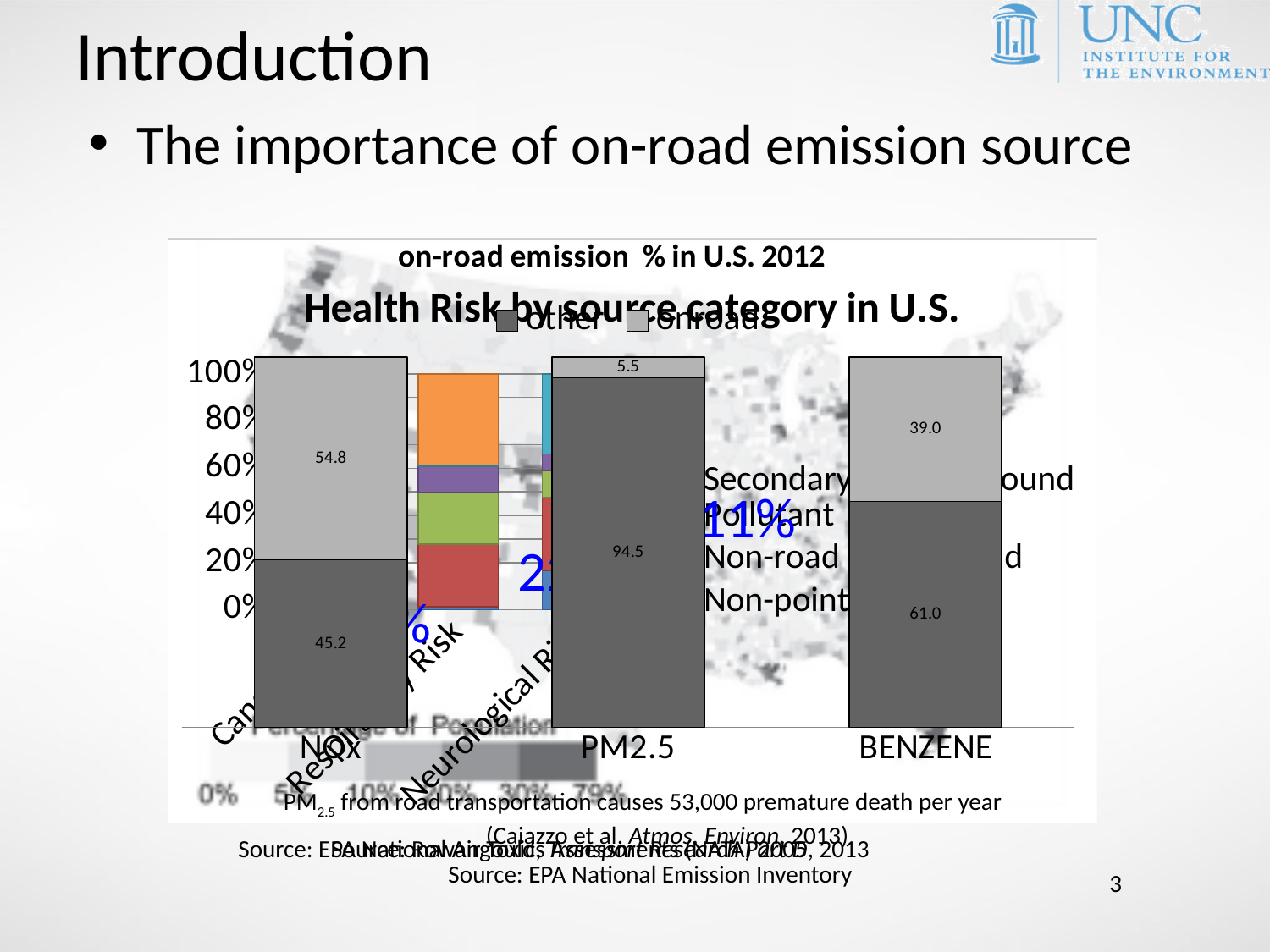
In the chart titled "on-road emission % in U.S. 2012", what are the two legend entries? other and onroad In the chart titled "on-road emission % in U.S. 2012", how many series does the legend list? 2 In the chart titled "on-road emission % in U.S. 2012", how many pollutant categories are shown on the x axis? 3 In the chart titled "on-road emission % in U.S. 2012", what is the On-road value for NOx? 54.8 In the chart titled "on-road emission % in U.S. 2012", is the On-road value larger for NOx or for BENZENE? NOx In the chart titled "on-road emission % in U.S. 2012", which pollutant has the lowest On-road share? PM2.5 In the chart titled "on-road emission % in U.S. 2012", what is the Other value for BENZENE? 61.0 In the chart titled "on-road emission % in U.S. 2012", what is the On-road value for BENZENE? 39.0 In the chart titled "on-road emission % in U.S. 2012", what is the difference between the Other value and the On-road value for PM2.5? 89.0 In the chart titled "on-road emission % in U.S. 2012", which pollutant has the highest On-road share? NOx What kind of chart is the "on-road emission % in U.S. 2012" chart? Stacked bar chart In the chart titled "on-road emission % in U.S. 2012", what is the Other value for PM2.5? 94.5